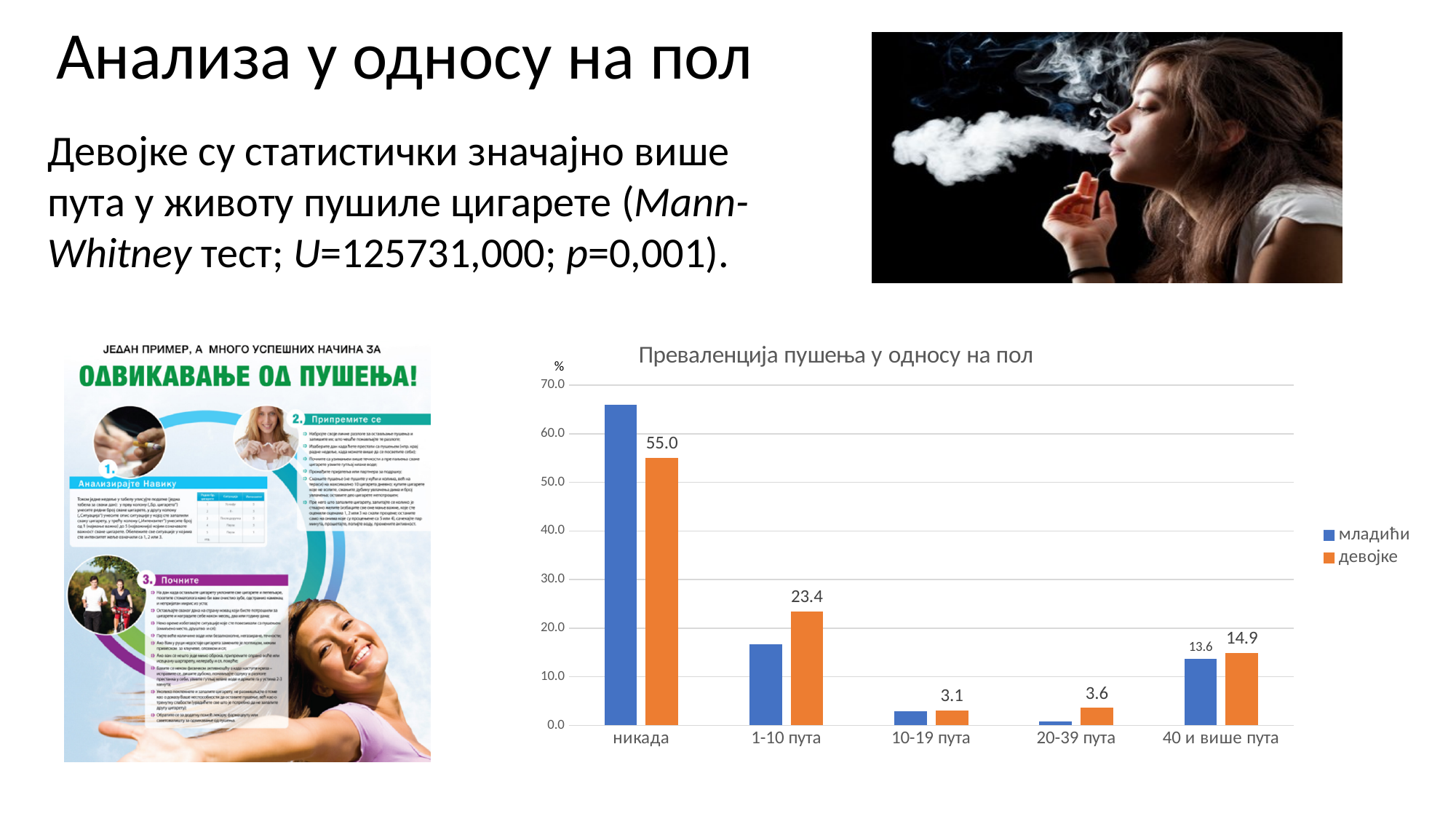
How many categories are shown on the x axis of the chart? 5 What is the difference between the девојке and младићи values in the 40 и више пута category? 1.3 What is the value for девојке in the 1-10 пута category? 23.4 How many series does the chart legend list? 2 Is the value for младићи in the 1-10 пута category greater or less than 20? less Is the value for младићи in the никада category greater or less than 60? greater In the никада category, which series has the larger value, младићи or девојке? младићи What is the value for девојке in the никада category? 55.0 What is the value for младићи in the 40 и више пута category? 13.6 What is the value for девојке in the 20-39 пута category? 3.6 In which category is the value for девојке lowest? 10-19 пута In which category is the value for девојке highest? никада